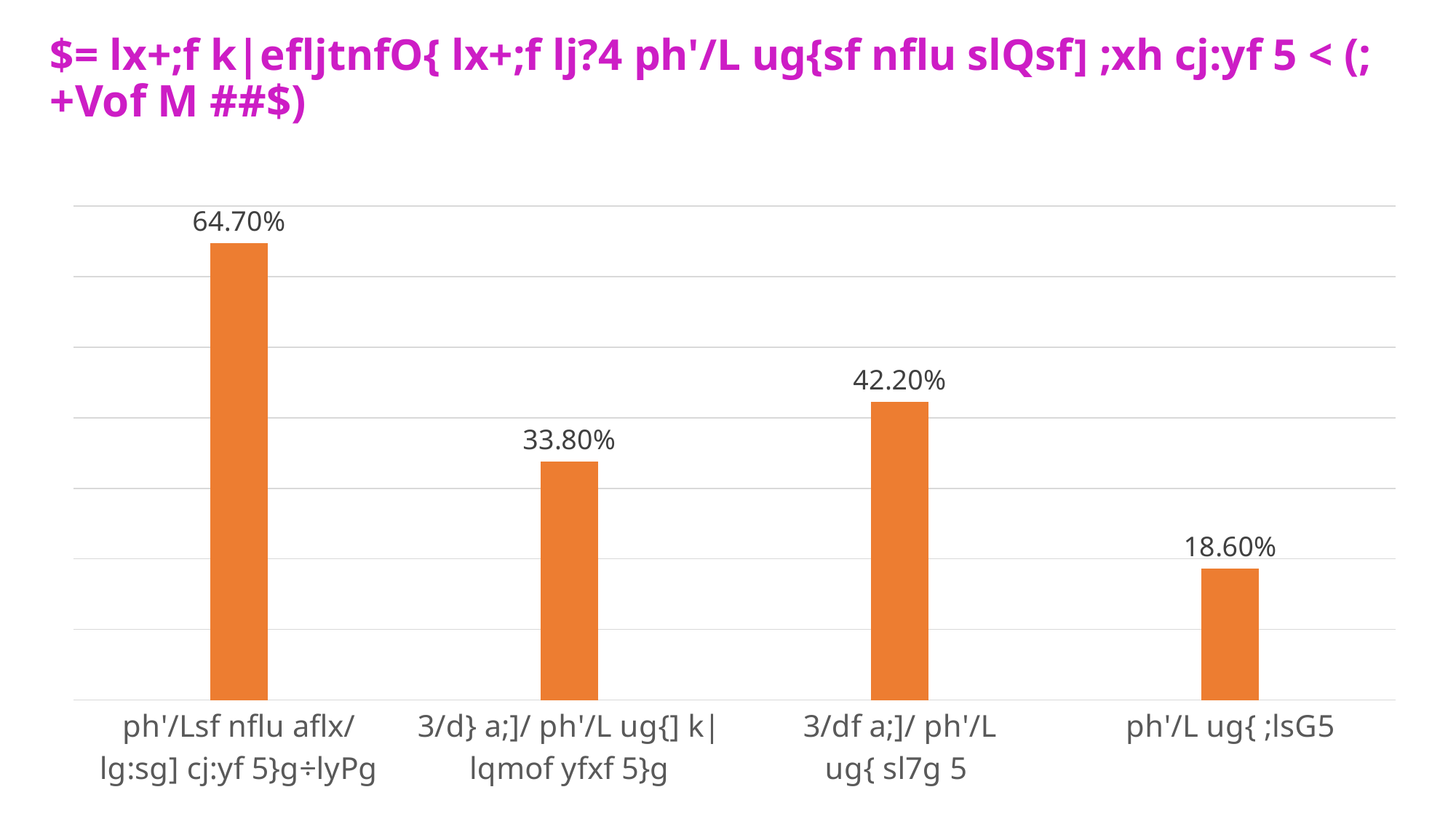
What is the difference between the third bar (42.20%) and the second bar (33.80%)? 8.40% What kind of chart is shown on the slide? bar chart Which is larger, the second bar or the third bar? the third bar What is the value of the third bar from the left? 42.20% What is the difference between the highest and lowest bar values? 46.10% What is the value of the fourth (rightmost) bar? 18.60% What is the value of the first (leftmost) bar? 64.70% Which bar has the lowest value? the fourth (rightmost) bar, 18.60% Which bar has the highest value? the first (leftmost) bar, 64.70% How many bars does the chart have? 4 What colour are the bars in the chart? orange What is the value of the second bar from the left? 33.80%